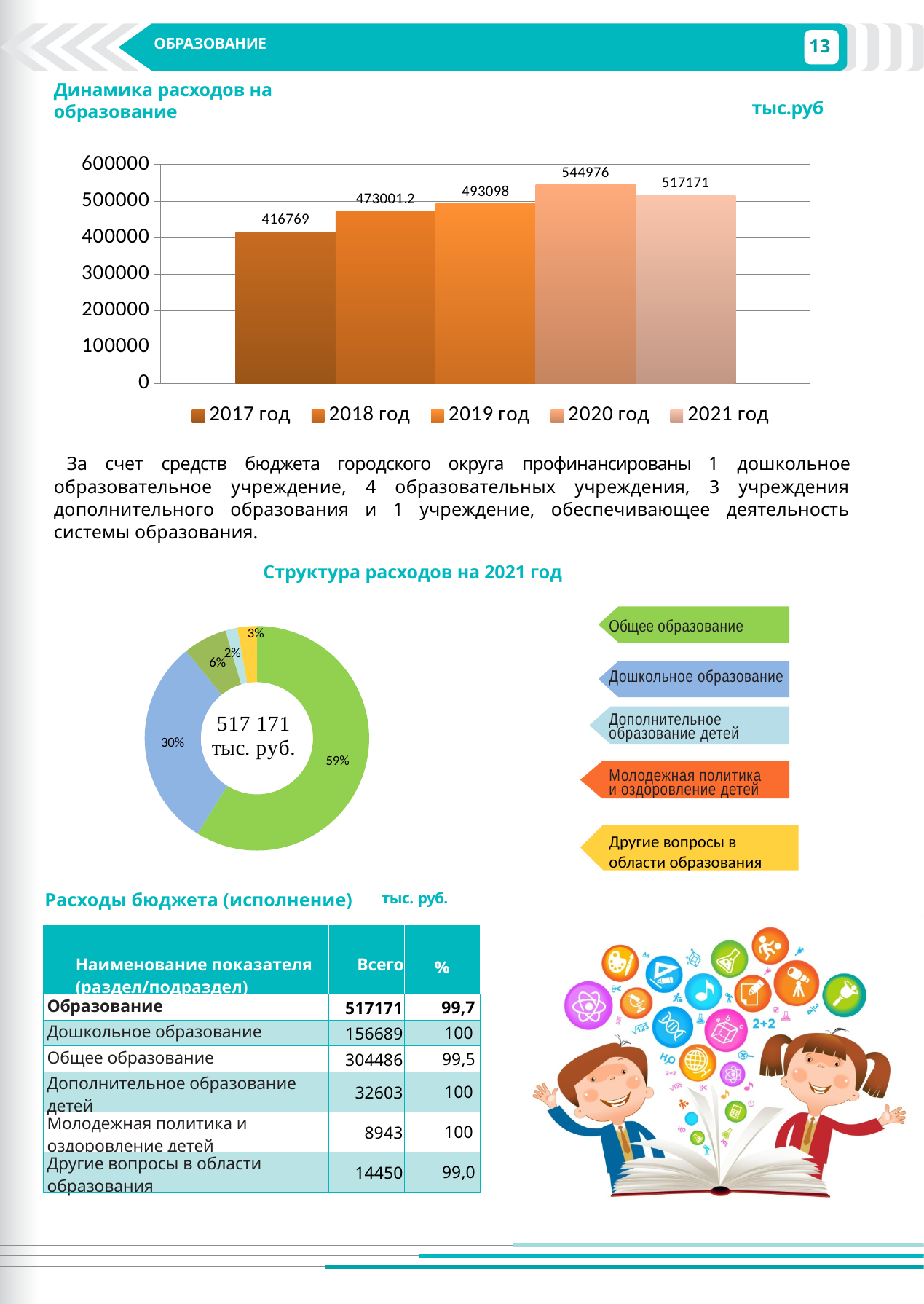
In the bar chart 'Динамика расходов на образование', what is the difference between the values for 2020 год and 2021 год? 27805 What kind of chart is 'Динамика расходов на образование'? bar chart In the chart 'Структура расходов на 2021 год', what share does Дошкольное образование have? 30% What kind of chart is 'Структура расходов на 2021 год'? doughnut chart In the bar chart 'Динамика расходов на образование', what is the value for 2021 год? 517171 In the bar chart 'Динамика расходов на образование', what is the value for 2018 год? 473001.2 In the bar chart 'Динамика расходов на образование', which is larger: the value for 2019 год or 2021 год? 2021 год In the bar chart 'Динамика расходов на образование', which year has the lowest value? 2017 год In the chart 'Структура расходов на 2021 год', what share does Общее образование have? 59% In the bar chart 'Динамика расходов на образование', which year has the highest value? 2020 год In the bar chart 'Динамика расходов на образование', how many years are shown? 5 In the bar chart 'Динамика расходов на образование', what is the value for 2017 год? 416769